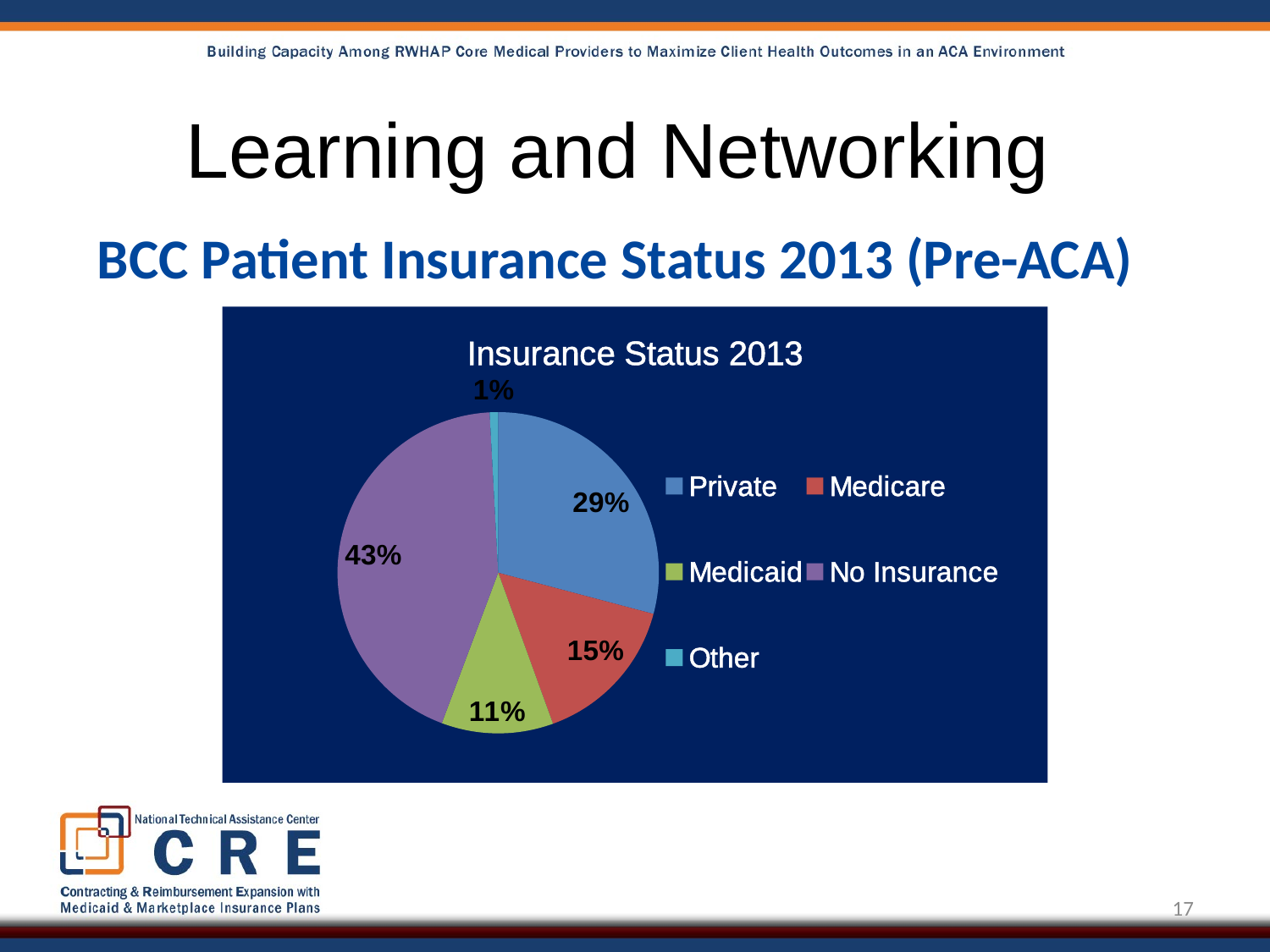
What percentage of patients had Private insurance? 29% What type of chart is shown on the slide? pie chart What percentage of patients fall under Other? 1% Which insurance status category has the smallest share of the pie? Other Which insurance status category has the largest share of the pie? No Insurance Which is larger, the share for Medicare or the share for Medicaid? Medicare What percentage of patients had No Insurance? 43% What percentage of patients had Medicaid? 11% What is the difference in percentage points between No Insurance and Private? 14 How many categories does the legend list? 5 What is the title of the chart? Insurance Status 2013 What percentage of patients had Medicare? 15%